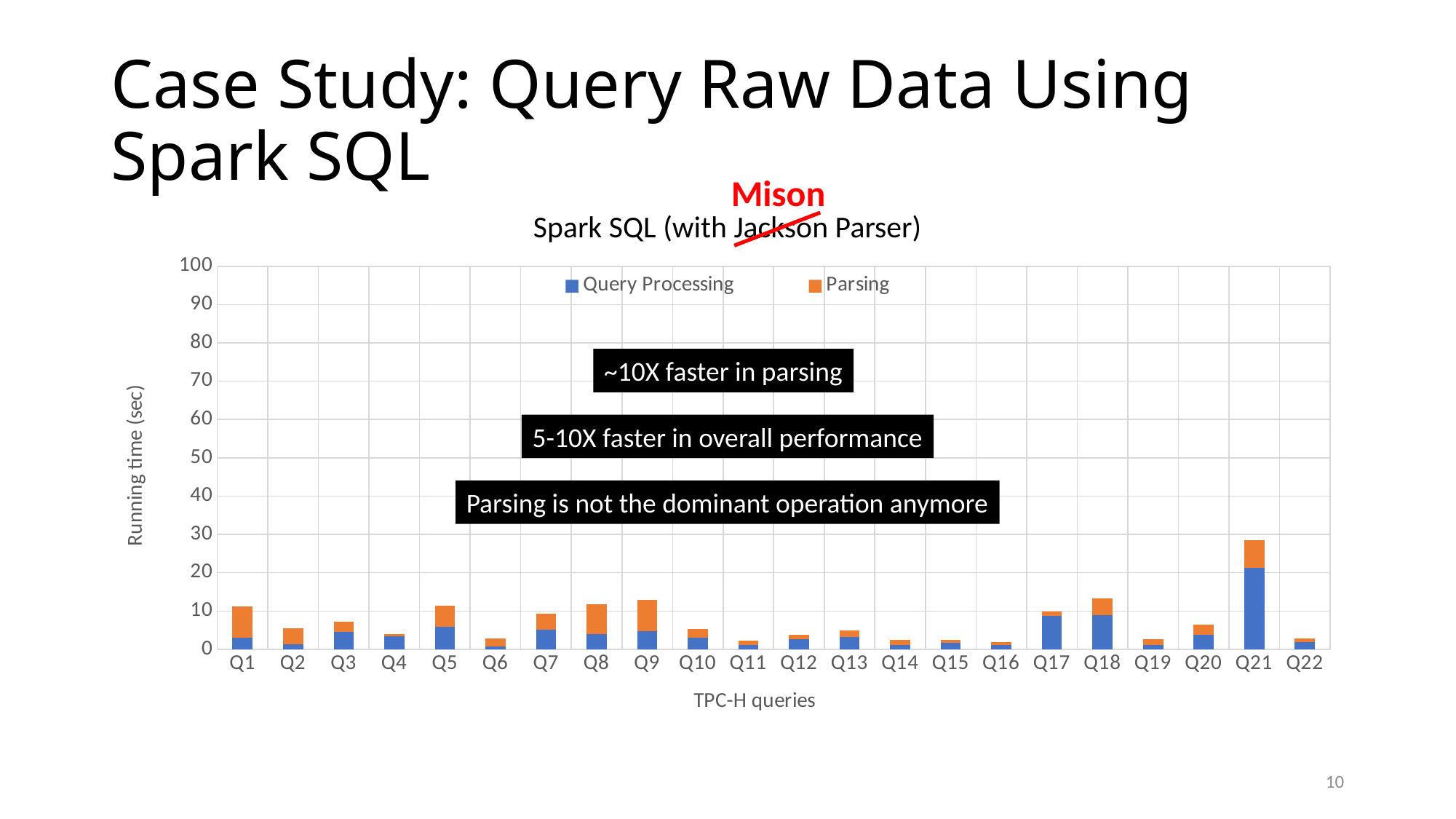
What kind of chart is shown on the slide? Stacked bar chart How many series does the chart's legend list? 2 Which query has the highest total running time in the chart? Q21 Is the total running time for Q21 greater or less than 20 seconds? greater Which has the larger total running time, Q21 or Q18? Q21 Is the total running time for Q6 greater or less than 5 seconds? less Is the total running time for Q17 greater or less than 5 seconds? greater What is the label on the chart's y axis? Running time (sec) What are the two series named in the chart's legend? Query Processing and Parsing How many TPC-H queries are shown along the x axis of the chart? 22 Which has the larger total running time, Q8 or Q4? Q8